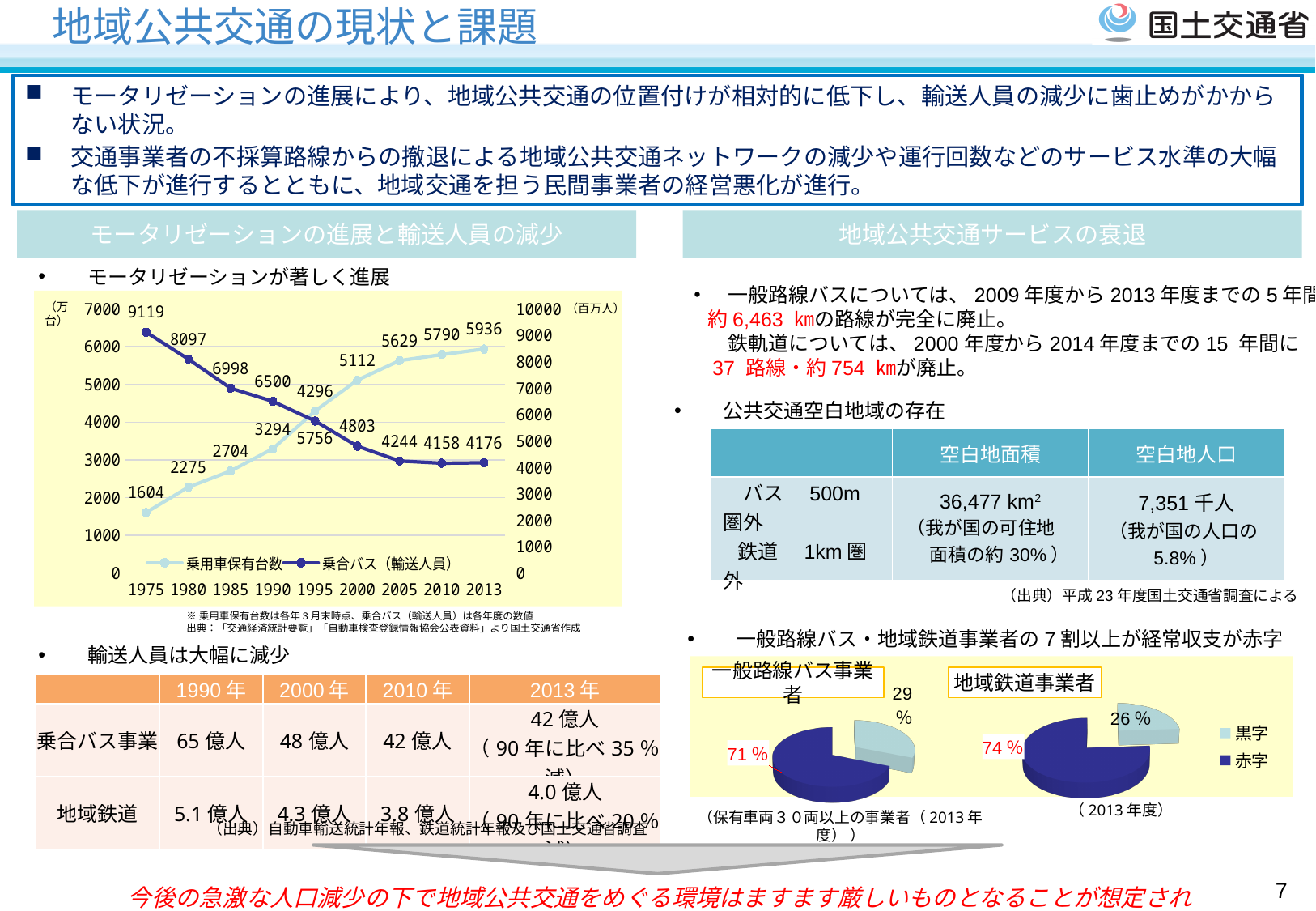
In the line chart on the left, what is the value of 乗合バス（輸送人員） in 1975? 9119 In the line chart on the left, what is the difference between 乗合バス（輸送人員） in 1975 and in 2013? 4943 Which is larger: the 赤字 share in the 一般路線バス事業者 pie chart or in the 地域鉄道事業者 pie chart? 地域鉄道事業者 In the line chart on the left, what is the value of 乗用車保有台数 in 1990? 3294 In the line chart on the left, what is the value of 乗用車保有台数 in 2013? 5936 In the pie chart titled 地域鉄道事業者, what share is 黒字? 26% In the line chart on the left, does 乗合バス（輸送人員） rise or fall from 1975 to 2013? fall In the line chart on the left, how many series does the legend list? 2 In the pie chart titled 一般路線バス事業者, what share is 赤字? 71% In the line chart on the left, what is the value of 乗合バス（輸送人員） in 2005? 4244 In the line chart on the left, in which year is 乗用車保有台数 lowest? 1975 In the line chart on the left, how many years are shown on the x axis? 9